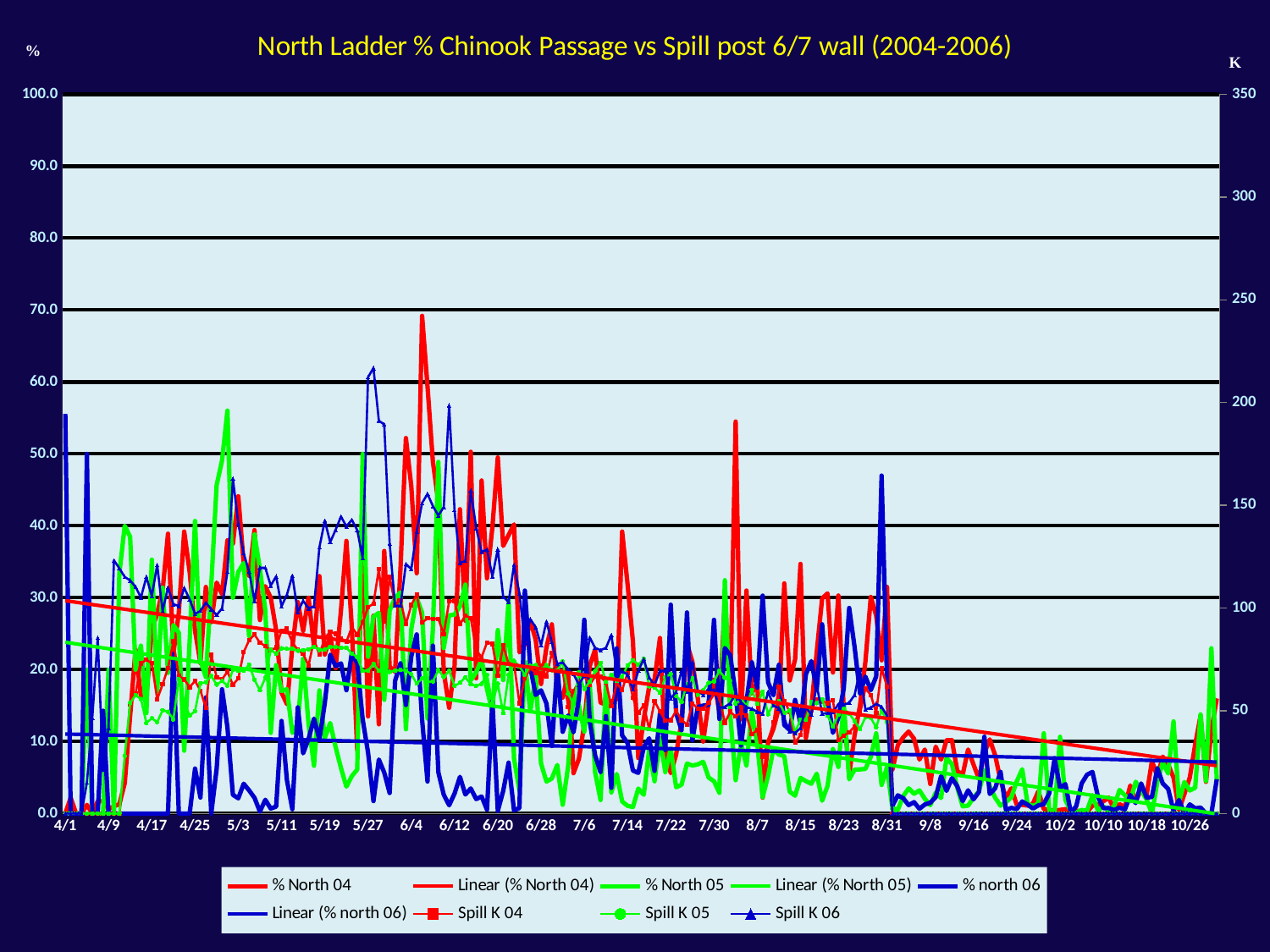
Does the Linear (% North 04) trend line rise or fall from left to right across the x axis? fall What is the maximum value shown on the left vertical axis? 100.0 Which of the three linear trend lines is the lowest at the left end of the chart (4/1)? Linear (% north 06) Does the Linear (% north 06) trend line rise or fall from left to right across the x axis? fall Does the Linear (% North 05) trend line rise or fall from left to right across the x axis? fall How many date labels are shown along the x axis? 27 Is the value of the Linear (% north 06) trend line at 4/1 greater or less than 20.0 on the left axis? less Is the highest peak reached by the % North 04 line greater or less than 60.0 on the left axis? greater What kind of chart is shown on the slide? line chart At the left end of the chart (4/1), which is higher: the Linear (% North 04) line or the Linear (% North 05) line? Linear (% North 04) What is the title of the chart? North Ladder % Chinook Passage vs Spill post 6/7 wall (2004-2006) How many series does the legend list? 9